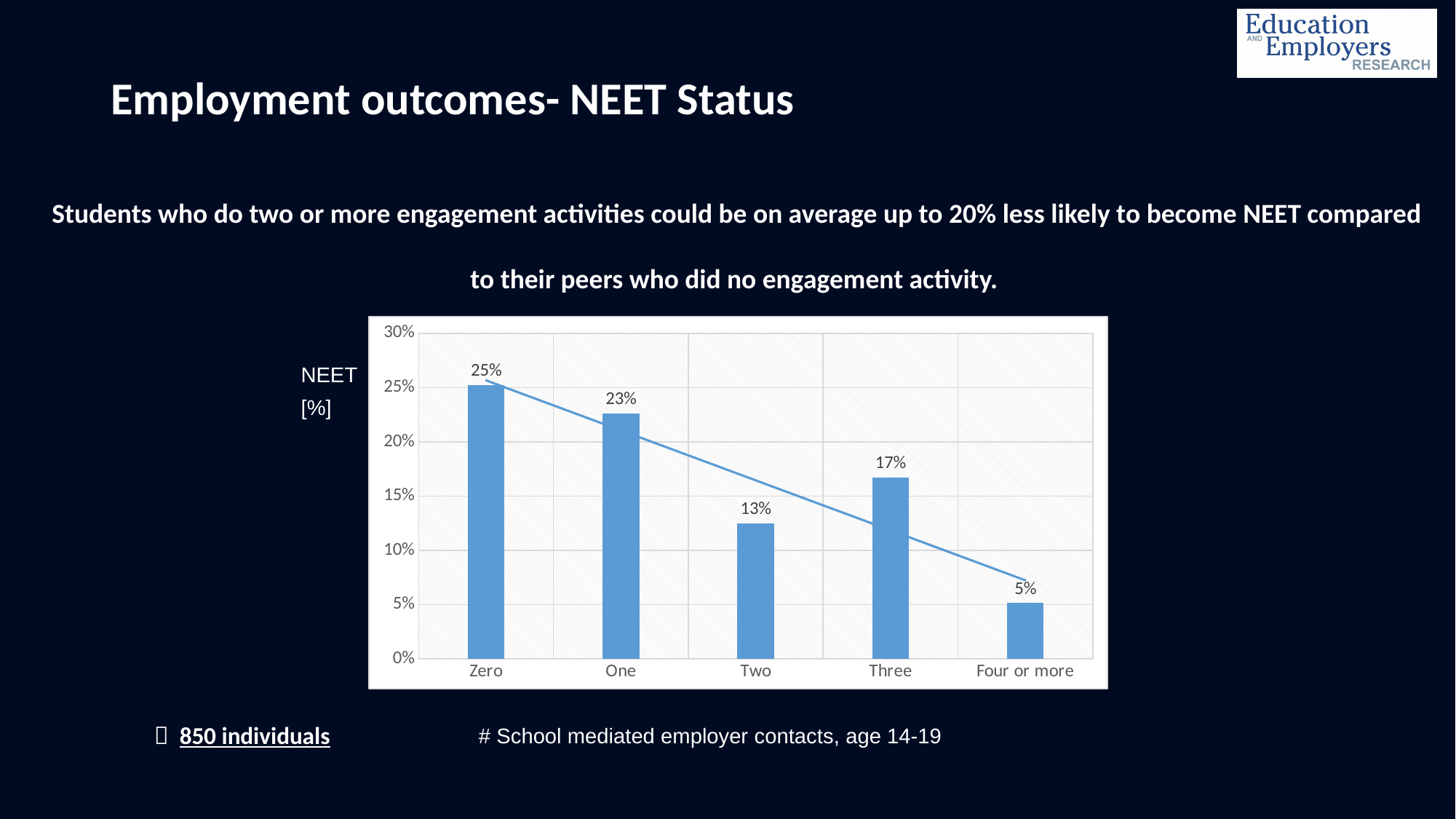
What is the difference in NEET percentage between the 'Zero' and 'Four or more' categories? 20% Which category has the lowest NEET percentage? Four or more What is the difference in NEET percentage between the 'One' and 'Two' categories? 10% What kind of chart is shown on the slide? Bar chart What is the NEET percentage for students with Zero school mediated employer contacts? 25% Is the NEET percentage for 'Three' greater or less than 20%? less What is the label of the x axis of the chart? # School mediated employer contacts, age 14-19 Which category has the highest NEET percentage? Zero What is the NEET percentage for the 'Four or more' category? 5% What is the NEET percentage for the 'Two' category? 13% Which has a higher NEET percentage, 'Two' or 'Three'? Three How many categories are shown on the x axis of the chart? 5